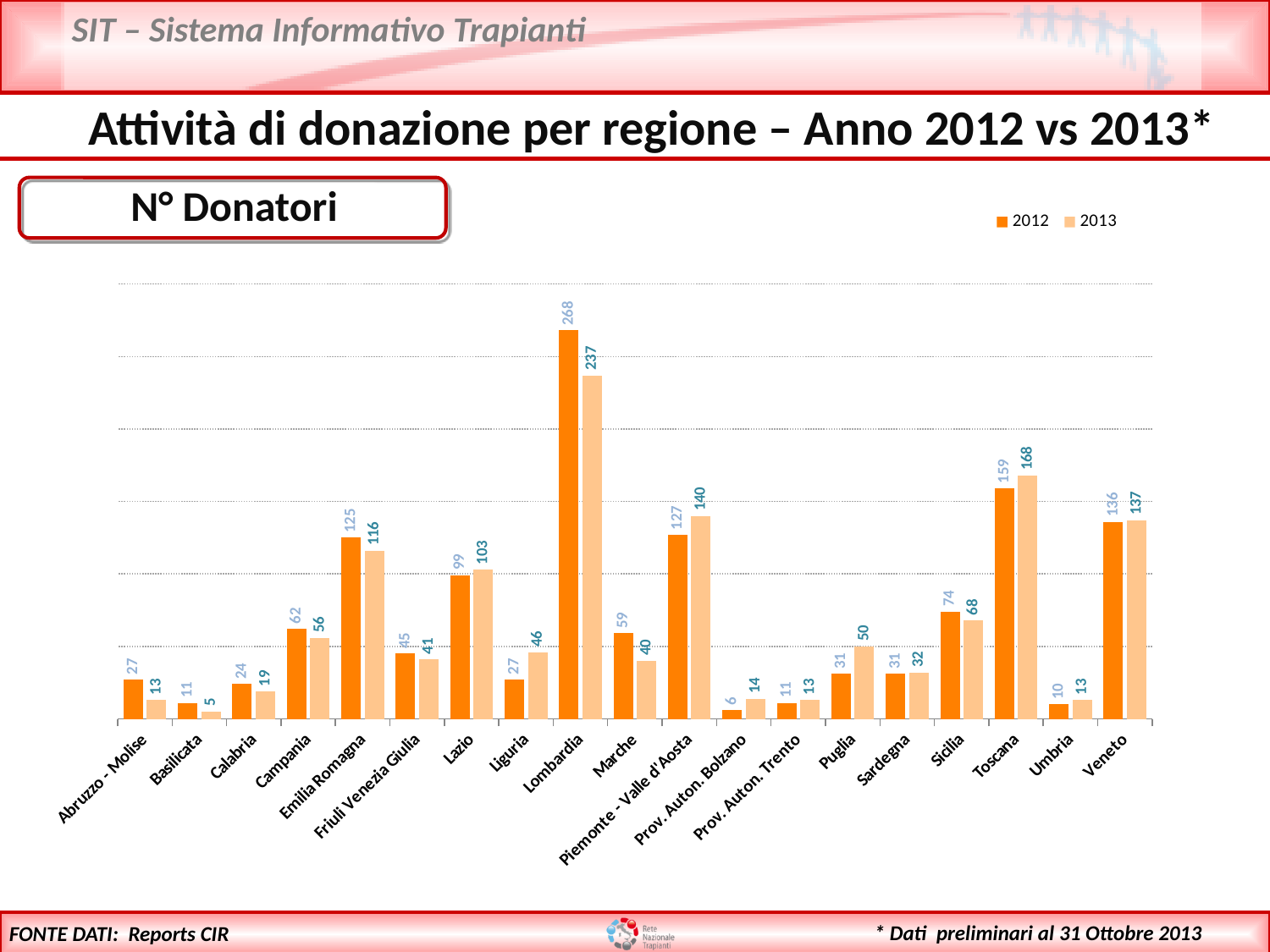
Which region has the lowest number of donors in 2013? Basilicata What is the difference between the 2012 and 2013 values for Lombardia? 31 What is the title shown in the box above the chart? N° Donatori How many series does the legend list? 2 What is the number of donors for Toscana in 2012? 159 Which is larger for Piemonte - Valle d'Aosta: the 2012 value or the 2013 value? 2013 What type of chart is shown on the slide? bar chart What is the difference between the 2013 and 2012 values for Puglia? 19 What is the number of donors for Prov. Auton. Bolzano in 2012? 6 How many regions are shown on the x axis? 19 What is the number of donors for Lombardia in 2013? 237 Which region has the highest number of donors in 2012? Lombardia